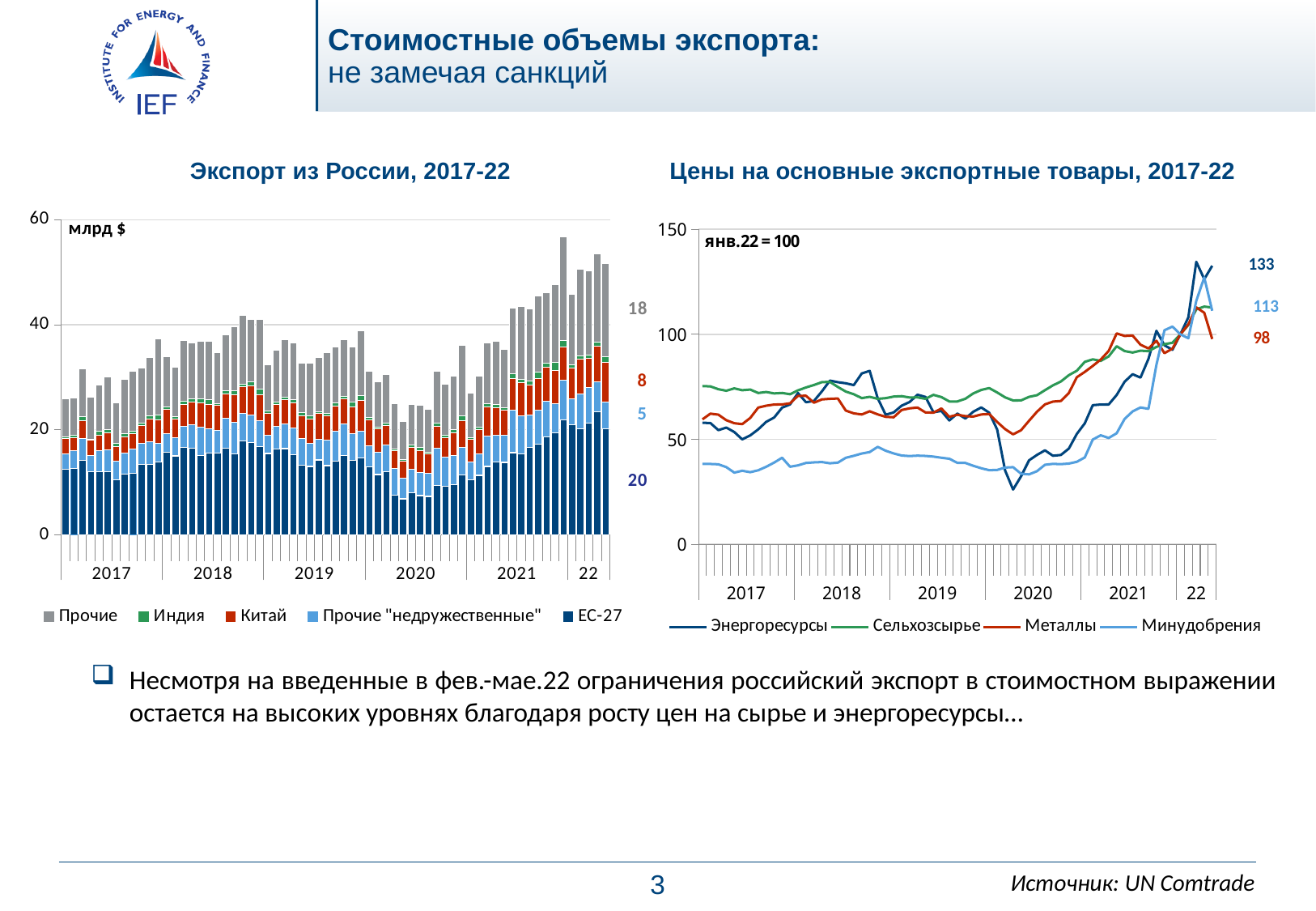
How many series does the legend of the left chart 'Экспорт из России, 2017-22' list? 5 What unit is shown on the left chart 'Экспорт из России, 2017-22'? млрд $ In the left chart 'Экспорт из России, 2017-22', what is the difference between the labelled values for ЕС-27 and Китай in the last bar? 12 What kind of chart is the left chart, 'Экспорт из России, 2017-22'? Stacked bar chart In the right chart 'Цены на основные экспортные товары, 2017-22', what is the difference between the labelled final values for Энергоресурсы and Металлы? 35 What kind of chart is the right chart, 'Цены на основные экспортные товары, 2017-22'? Line chart In the right chart 'Цены на основные экспортные товары, 2017-22', is the value for Минудобрения in 2017 greater or less than 50? less In the right chart 'Цены на основные экспортные товары, 2017-22', what is the labelled final value for Энергоресурсы? 133 How many series does the legend of the right chart 'Цены на основные экспортные товары, 2017-22' list? 4 In the left chart 'Экспорт из России, 2017-22', what is the labelled value for ЕС-27 in the last bar? 20 In the left chart 'Экспорт из России, 2017-22', what is the labelled value for Прочие in the last bar? 18 In the left chart 'Экспорт из России, 2017-22', what is the labelled value for Китай in the last bar? 8